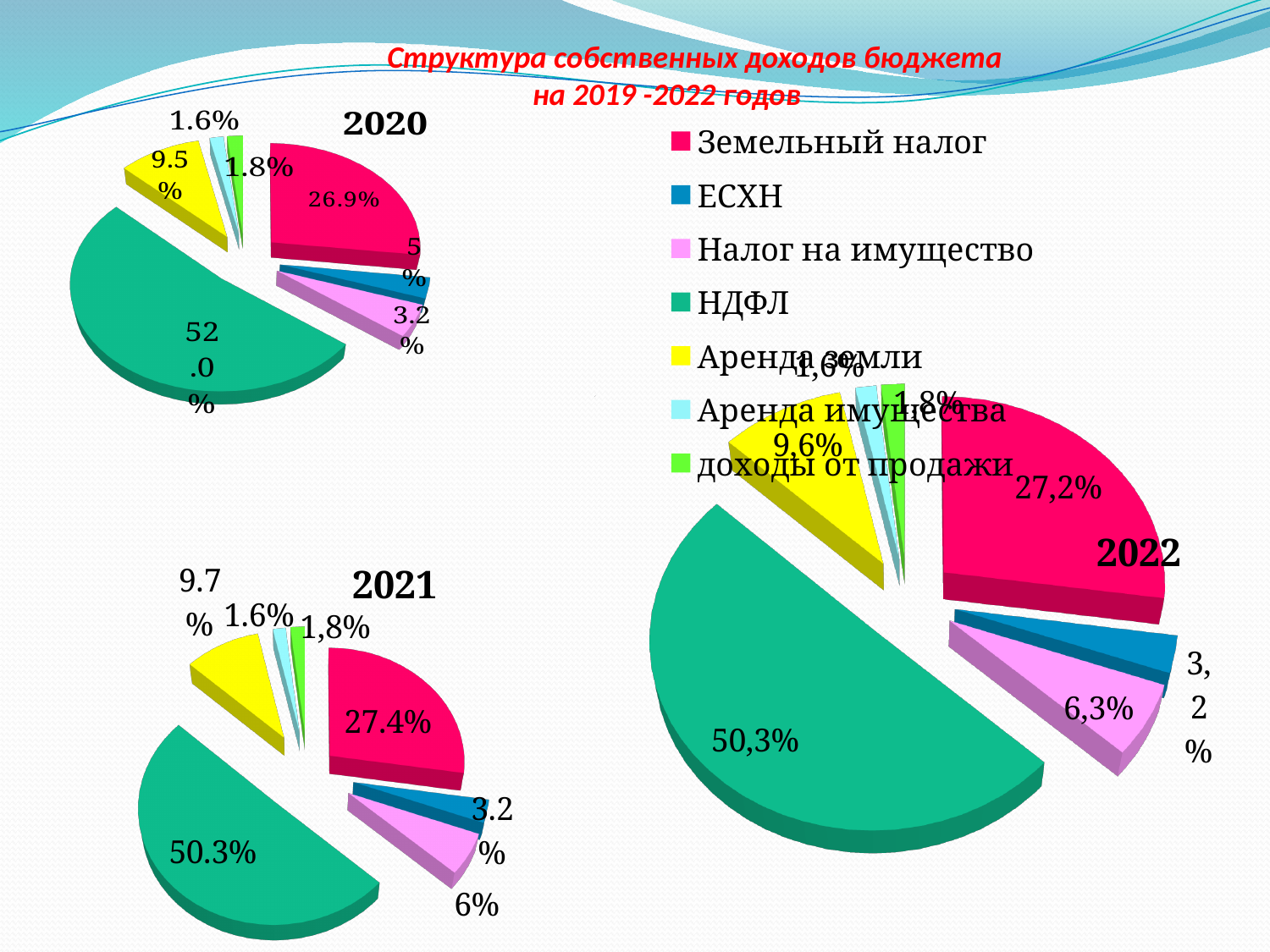
What type of chart is used for the 2020, 2021 and 2022 data? Pie chart In the 2022 pie chart, what is the value for ЕСХН? 3,2% In the 2022 pie chart, which is larger: Налог на имущество or ЕСХН? Налог на имущество In the 2020 pie chart, what share does НДФЛ have? 52.0% In the 2021 pie chart, what is the difference between the shares of Земельный налог and Аренда земли? 17.7% How many categories does the legend list? 7 In the 2021 pie chart, what is the value for Аренда земли? 9.7% In the 2021 pie chart, which category has the largest share? НДФЛ In the 2020 pie chart, which category has the smallest share? Аренда имущества Which colour represents НДФЛ in the legend? Teal (sea green) In the 2020 pie chart, what is the value for Земельный налог? 26.9% In the 2022 pie chart, what is the value for Налог на имущество? 6,3%